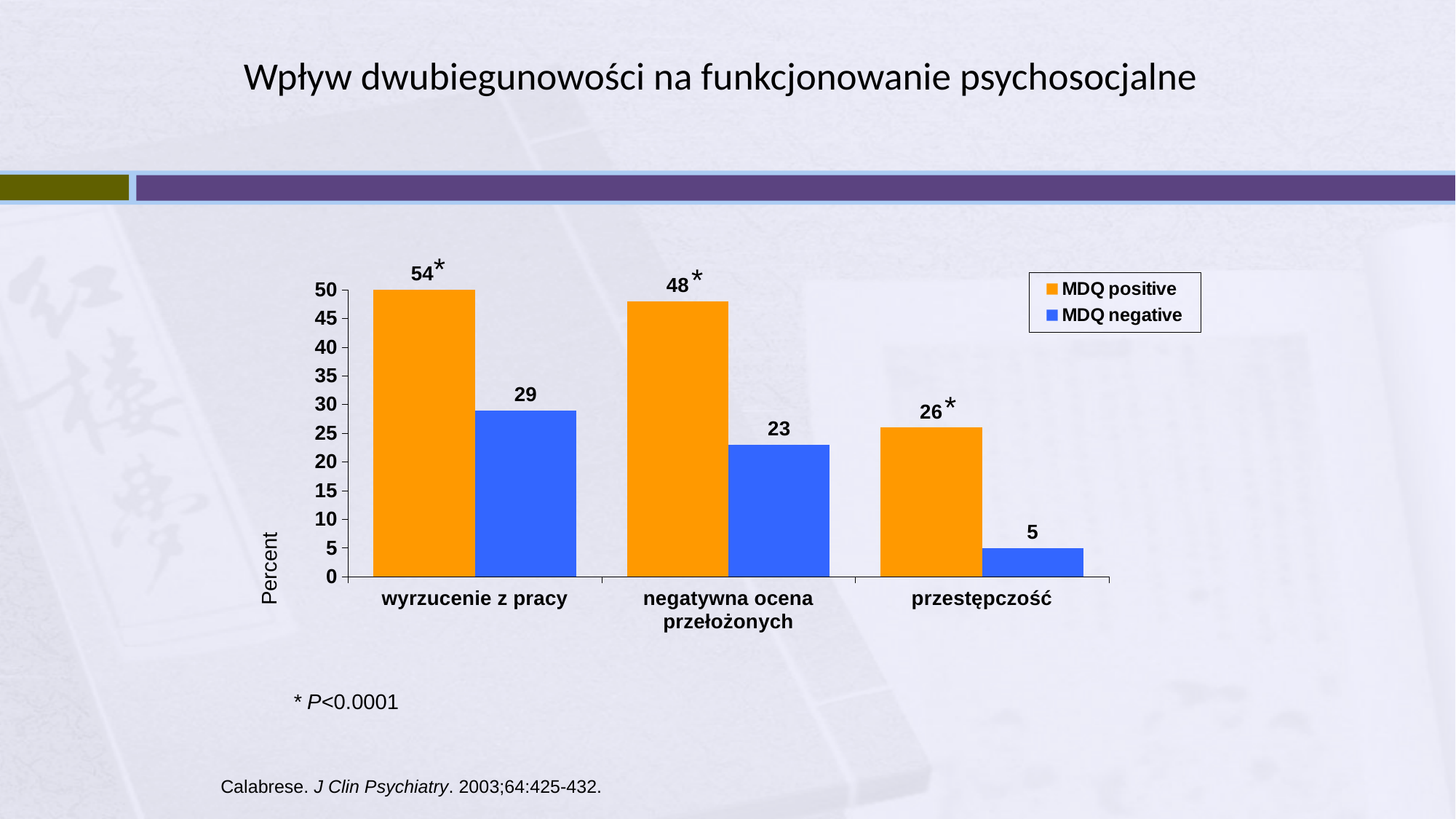
Which is larger for przestępczość, the MDQ positive value or the MDQ negative value? MDQ positive What kind of chart is shown on the slide? bar chart What is the MDQ negative value for negatywna ocena przełożonych? 23 What is the MDQ positive value for wyrzucenie z pracy? 54 How many categories are shown on the x axis? 3 Which category has the lowest MDQ negative value? przestępczość What is the difference between the MDQ positive and MDQ negative values for wyrzucenie z pracy? 25 What is the difference between the MDQ positive values for negatywna ocena przełożonych and przestępczość? 22 What is the label of the y axis? Percent How many series does the legend list? 2 What is the MDQ negative value for przestępczość? 5 Which category has the highest MDQ positive value? wyrzucenie z pracy